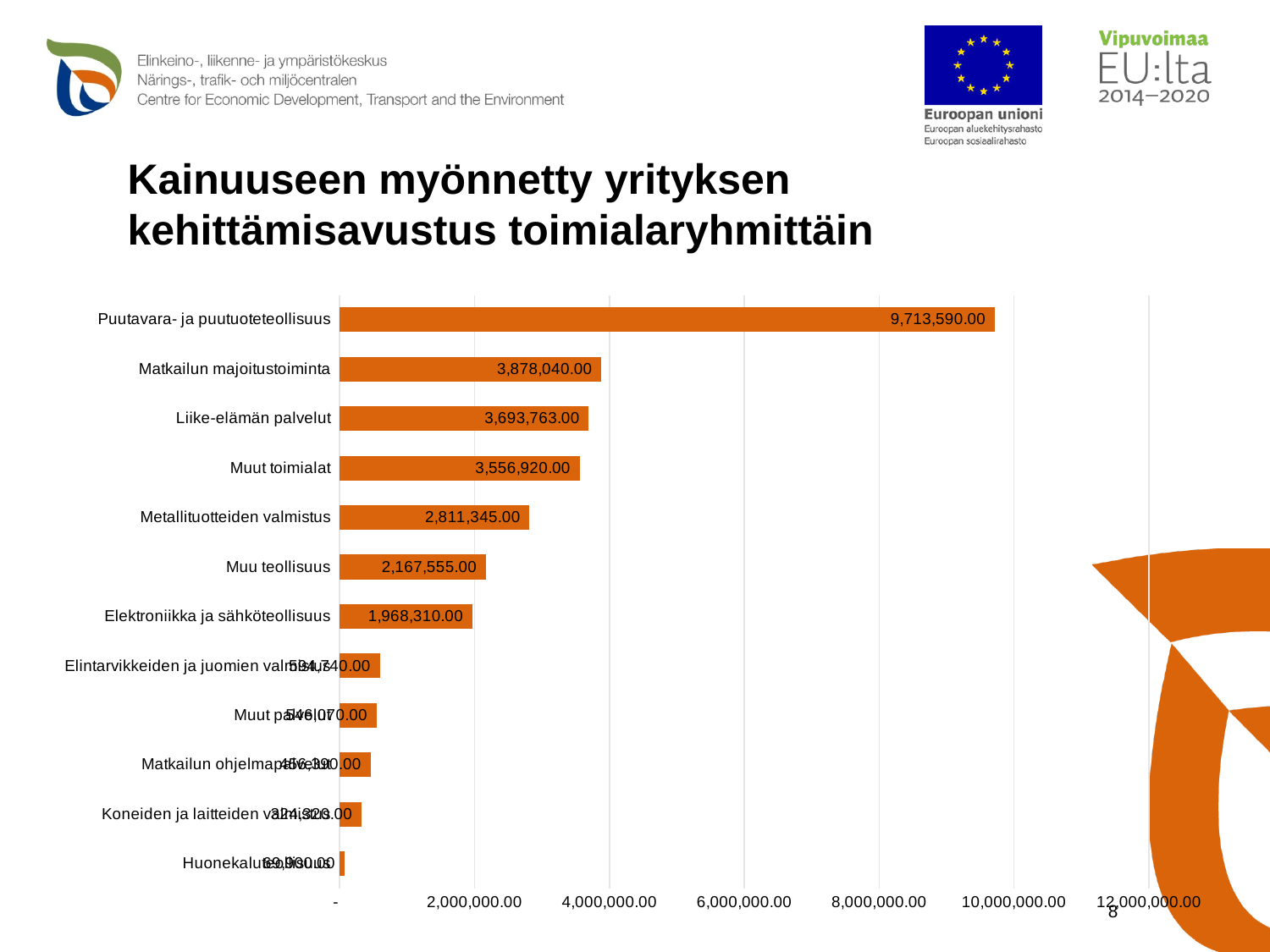
What is the value for Puutavara- ja puutuoteteollisuus? 9,713,590.00 What is the difference between the values for Puutavara- ja puutuoteteollisuus and Matkailun majoitustoiminta? 5,835,550.00 Which is larger, the value for Liike-elämän palvelut or the value for Muut toimialat? Liike-elämän palvelut Is the value for Metallituotteiden valmistus greater or less than 4,000,000.00? less What is the value for Elektroniikka ja sähköteollisuus? 1,968,310.00 What is the value for Matkailun majoitustoiminta? 3,878,040.00 What is the value for Metallituotteiden valmistus? 2,811,345.00 How many categories are shown in the chart? 12 What is the difference between the values for Metallituotteiden valmistus and Muu teollisuus? 643,790.00 Which category has the highest value? Puutavara- ja puutuoteteollisuus What is the title of the slide? Kainuuseen myönnetty yrityksen kehittämisavustus toimialaryhmittäin What type of chart is shown on the slide? bar chart